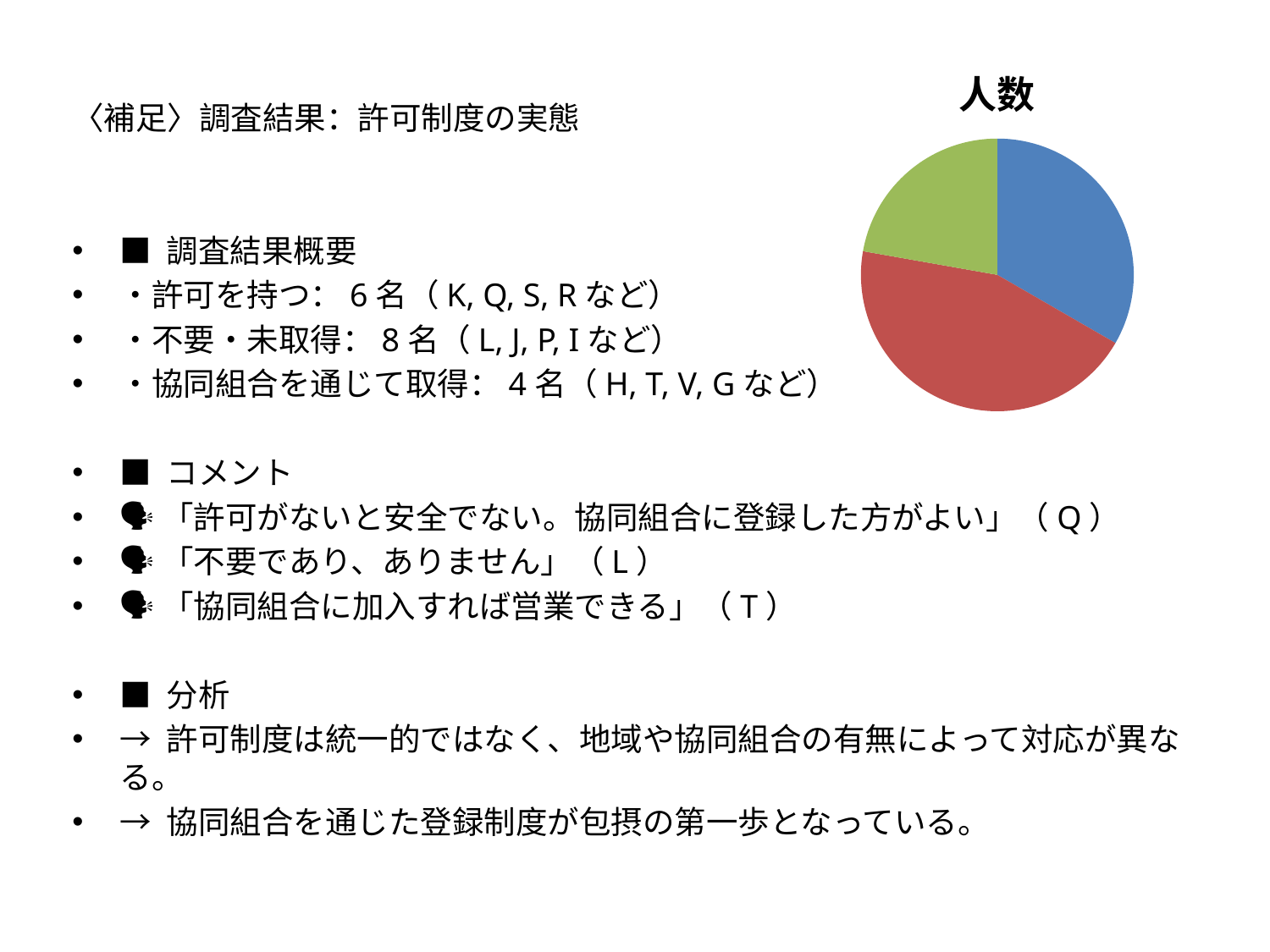
How many slices does the pie chart have? 3 Does the pie chart display a legend? No Which slice is larger in the pie chart, the red slice or the blue slice? red Which colour slice is the smallest in the pie chart? green What is the title of the pie chart? 人数 Which slice is larger in the pie chart, the blue slice or the green slice? blue Which colour slice is the largest in the pie chart? red What kind of chart is shown on the slide? pie chart